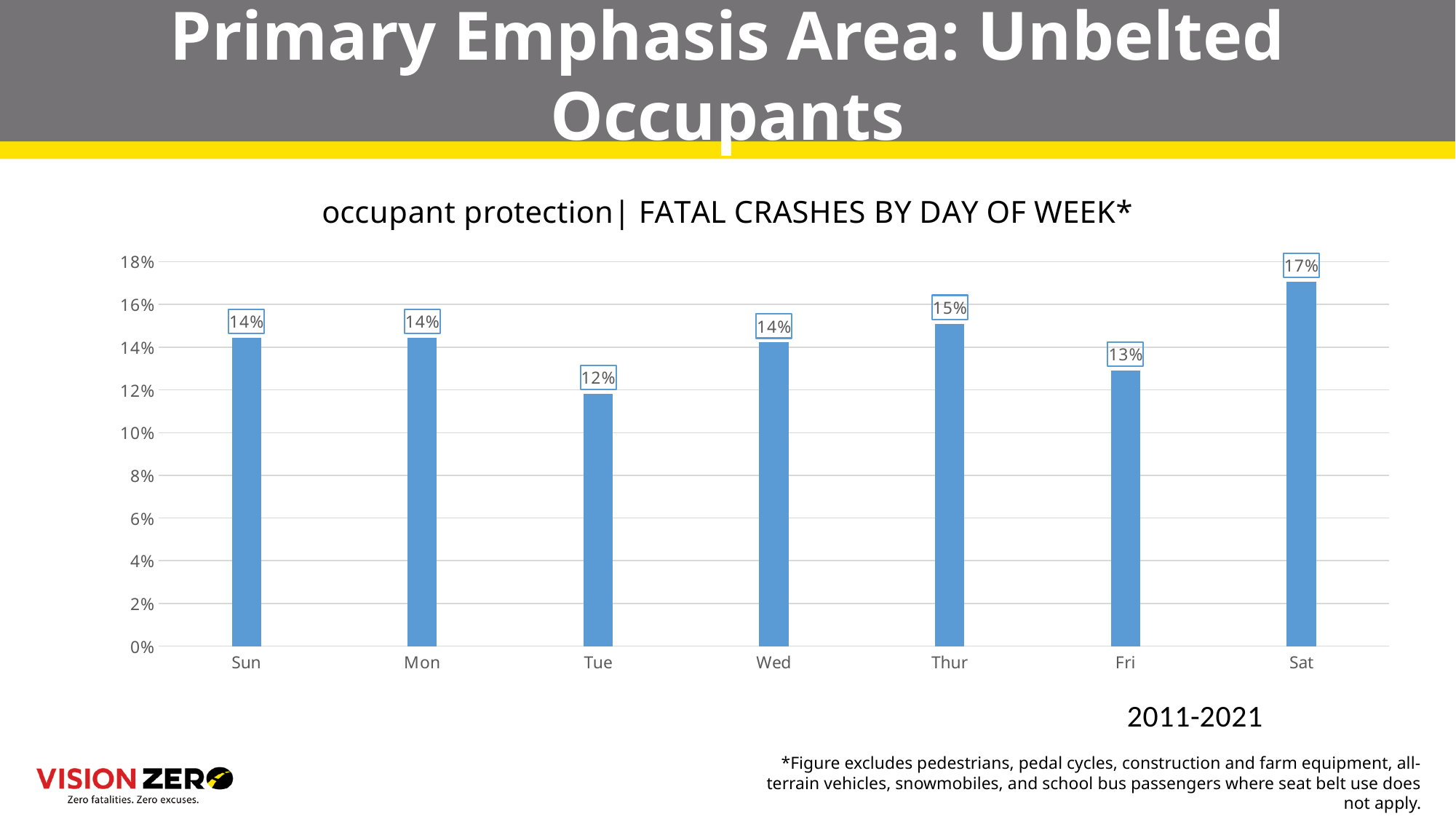
Which day of the week has the highest share of fatal crashes? Sat Which is larger, the value for Thur or the value for Fri? Thur What is the value shown for Tue? 12% What is the title of the chart? occupant protection| FATAL CRASHES BY DAY OF WEEK* What is the difference between the values for Sat and Tue? 5% Which day of the week has the lowest share of fatal crashes? Tue What percentage of fatal crashes occurred on Saturday? 17% What kind of chart is shown on the slide? Bar chart What is the value shown for Thur? 15% How many days of the week are shown on the x axis? 7 What is the value shown for Fri? 13% Is the value for Sat greater or less than 16%? greater